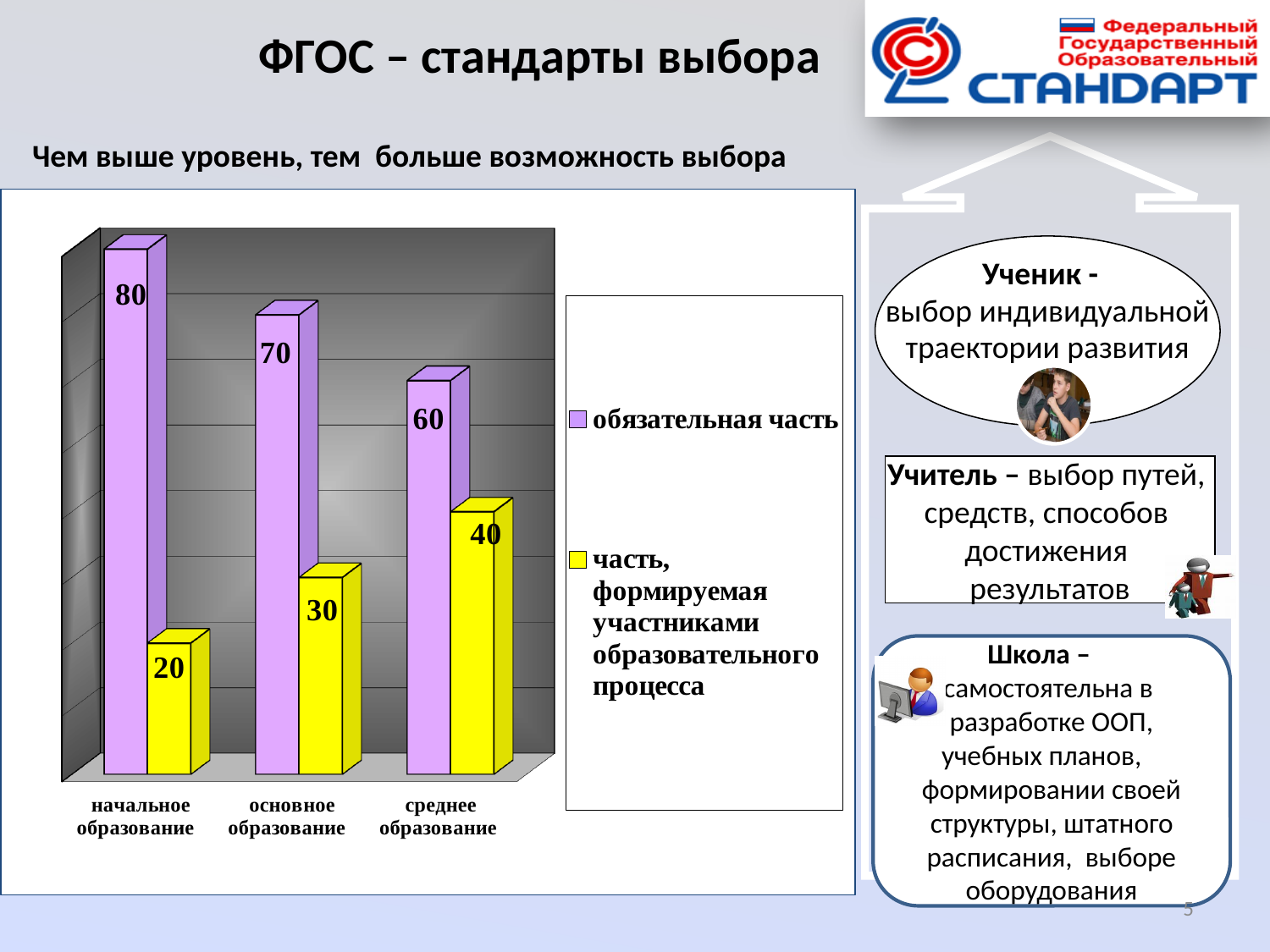
What colour are the bars for 'обязательная часть'? purple What is the value of 'часть, формируемая участниками образовательного процесса' for 'среднее образование'? 40 Does the value of 'обязательная часть' rise or fall from 'начальное образование' to 'среднее образование'? fall What kind of chart is shown on the slide? bar chart Which category has the lowest value for 'часть, формируемая участниками образовательного процесса'? начальное образование What is the difference between 'обязательная часть' and 'часть, формируемая участниками образовательного процесса' for 'основное образование'? 40 Which category has the highest value for 'обязательная часть'? начальное образование What is the value of 'обязательная часть' for 'начальное образование'? 80 How many series does the legend list? 2 How many categories are shown on the x axis of the chart? 3 Which is larger: 'обязательная часть' for 'среднее образование' or 'часть, формируемая участниками образовательного процесса' for 'среднее образование'? обязательная часть What is the value of 'обязательная часть' for 'основное образование'? 70